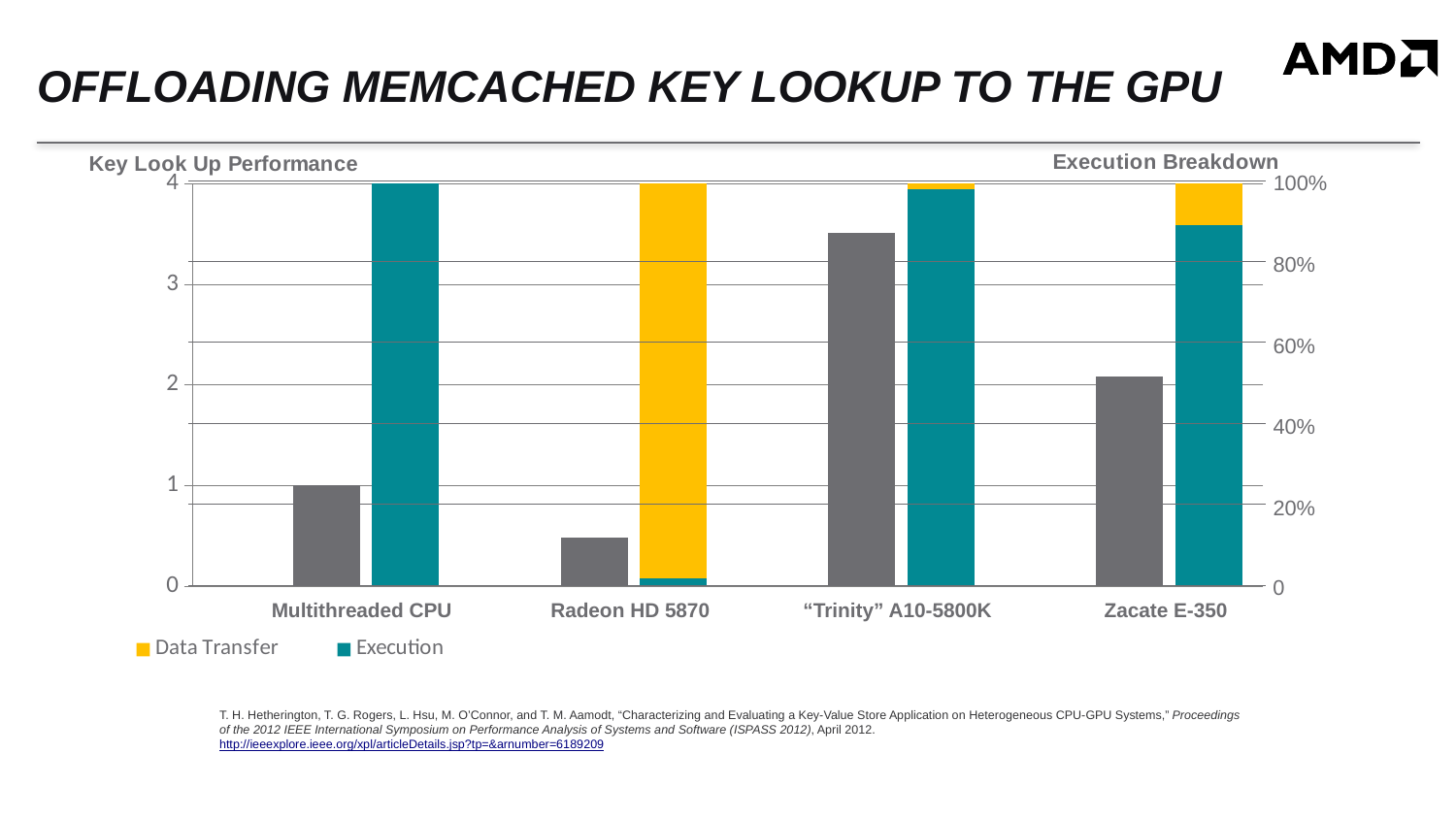
Is the Data Transfer share for Radeon HD 5870 greater or less than 80%? greater What kind of chart is shown on the slide? Bar chart Which category has the lowest Key Look Up Performance bar? Radeon HD 5870 How many series does the legend list? 2 What is the Key Look Up Performance value for Multithreaded CPU? 1 Which category has the highest Key Look Up Performance bar? "Trinity" A10-5800K Is the Execution share for Radeon HD 5870 greater or less than 20%? less Which has the larger Key Look Up Performance bar, "Trinity" A10-5800K or Zacate E-350? "Trinity" A10-5800K Is the Key Look Up Performance value for Radeon HD 5870 greater or less than 1? less How many categories are shown on the x axis of the chart? 4